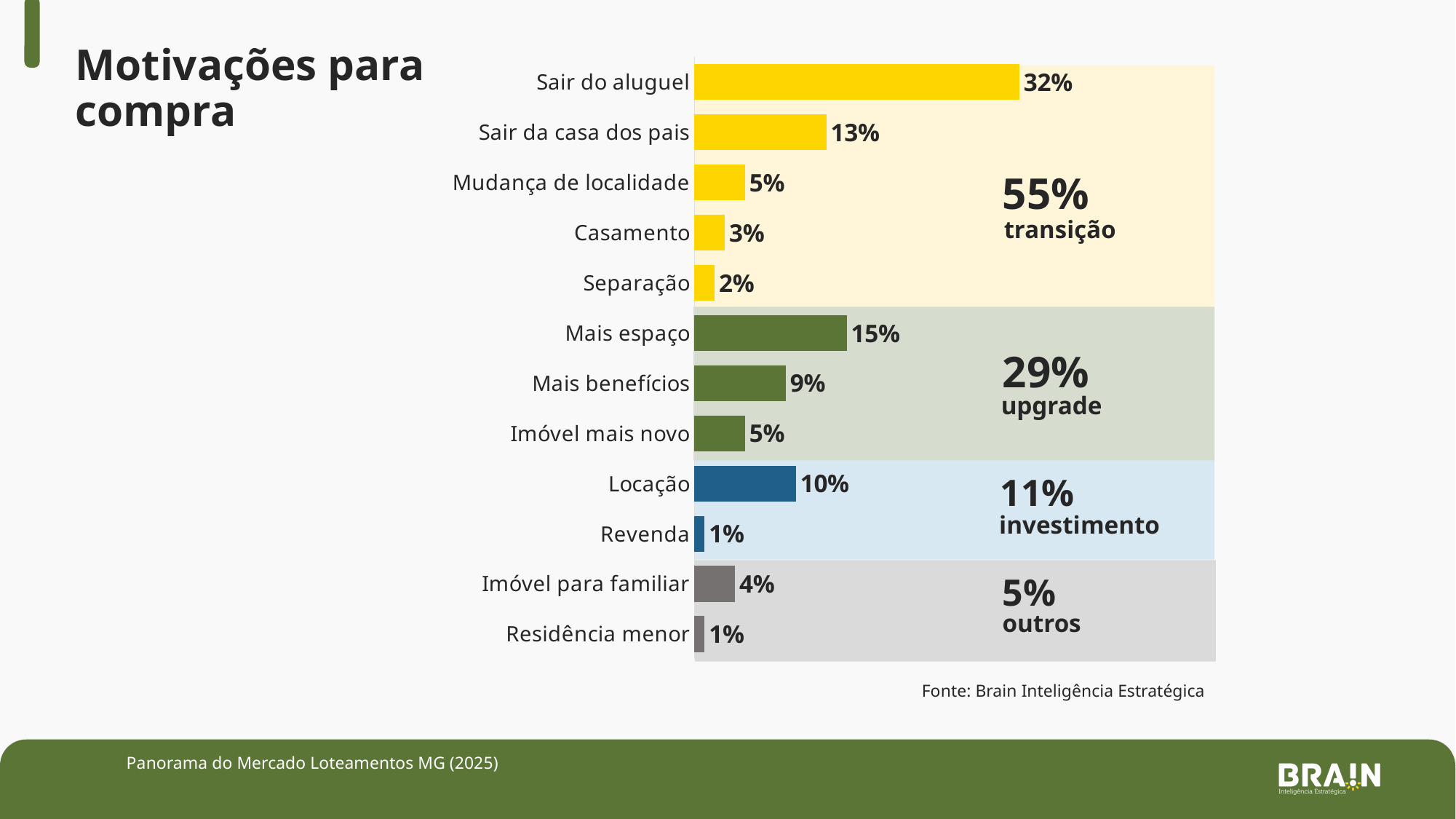
What is the total share for the "transição" group? 55% Which is larger, "Mais benefícios" or "Locação"? Locação Which category has the highest value? Sair do aluguel What is the value for "Locação"? 10% What is the value for "Sair do aluguel"? 32% What is the difference between "Mais espaço" and "Imóvel mais novo"? 10% What is the difference between "Sair do aluguel" and "Sair da casa dos pais"? 19% What is the value for "Imóvel para familiar"? 4% What is the value for "Mais espaço"? 15% How many categories are shown in the chart? 12 What is the title of the chart? Motivações para compra What kind of chart is shown on the slide? Bar chart